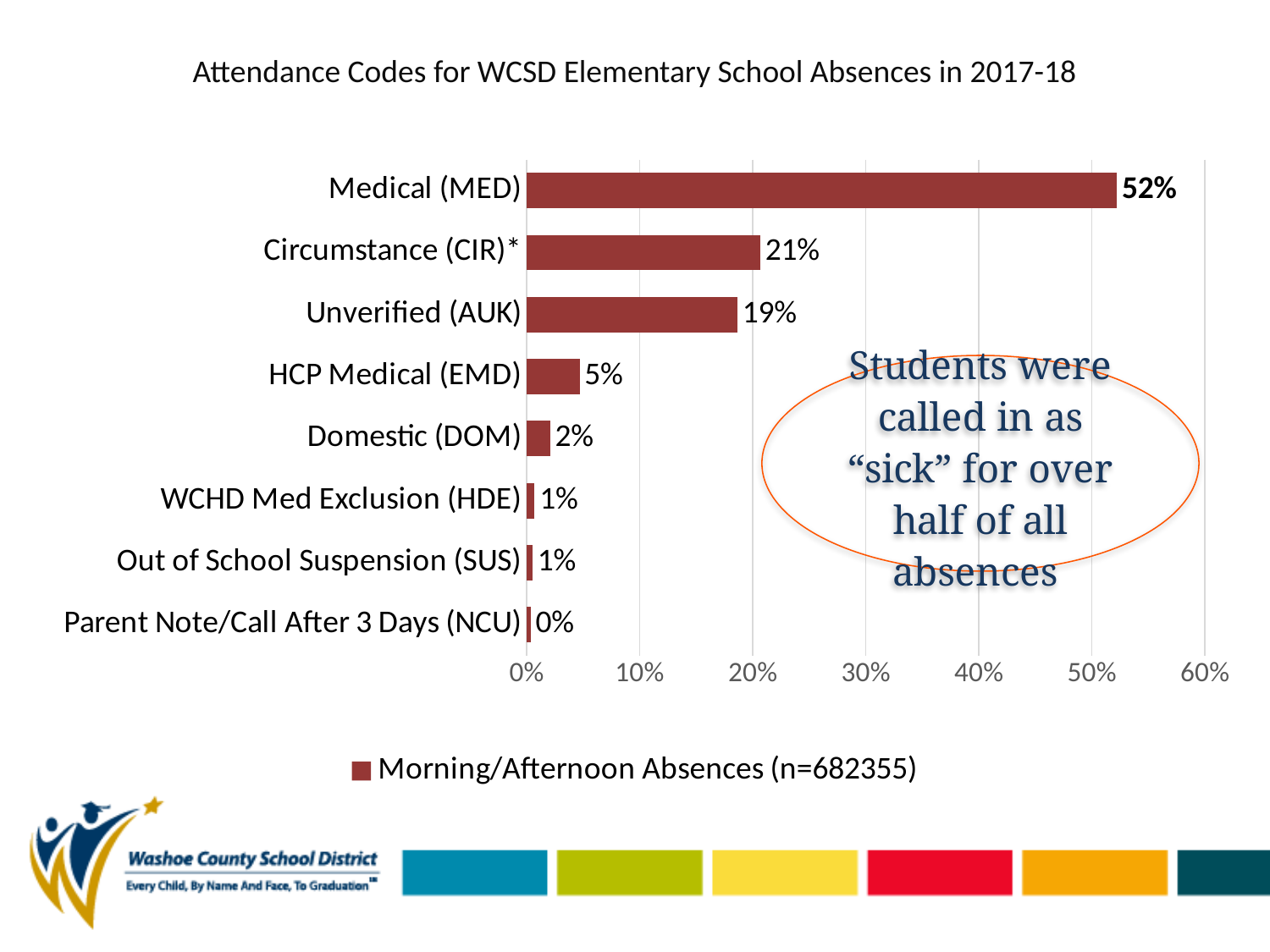
Which attendance code has the lowest share of absences? Parent Note/Call After 3 Days (NCU) What is the value for Domestic (DOM)? 2% What is the difference between the values for Medical (MED) and Circumstance (CIR)*? 31% What percentage of absences is shown for Medical (MED)? 52% What is the value for HCP Medical (EMD)? 5% What is the value for Unverified (AUK)? 19% Is the value for Medical (MED) greater or less than 50%? greater What kind of chart is shown on the slide? Bar chart What is the legend entry for the series in the chart? Morning/Afternoon Absences (n=682355) Which attendance code has the highest share of absences? Medical (MED) Which is larger, the value for Circumstance (CIR)* or Unverified (AUK)? Circumstance (CIR)* How many attendance codes are shown in the chart? 8